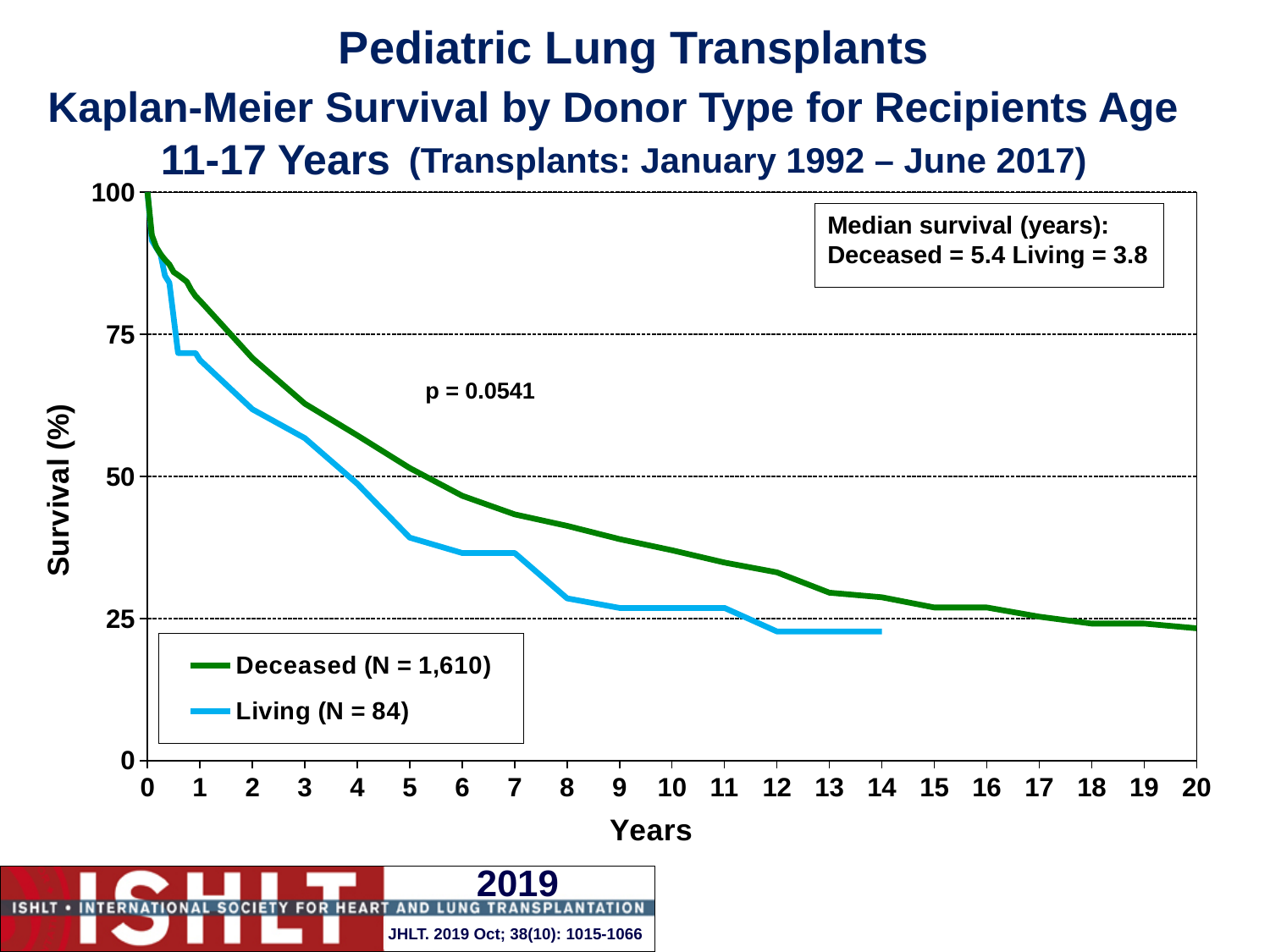
What is the difference in median survival (years) between the Deceased and Living groups? 1.6 What is the median survival in years for the Living donor group? 3.8 What is the N for the Deceased group shown in the legend? 1,610 What is the p-value shown on the chart? 0.0541 Is the survival for the Living group at 5 years greater or less than 50? less What is the median survival in years for the Deceased donor group? 5.4 How many series does the legend list? 2 Is the survival for the Deceased group at 10 years greater or less than 50? less Is the survival for the Deceased group at 1 year greater or less than 75? greater Do the survival curves rise or fall as years increase? fall What kind of chart is shown on the slide? line chart Which donor group has the higher median survival? Deceased